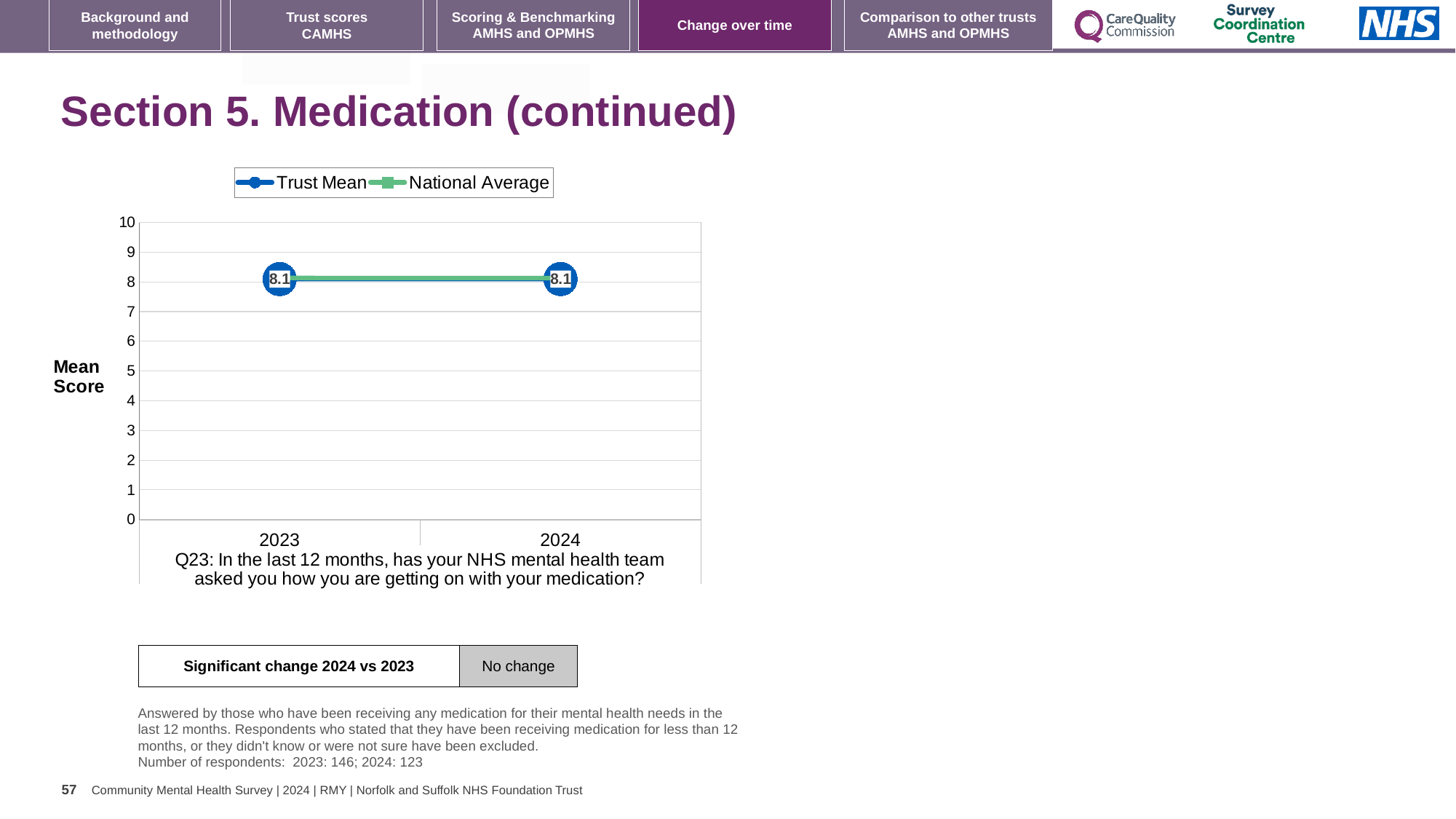
Is the Trust Mean value for 2023 greater or less than 9? less Which series is shown in green in the legend? National Average What is the Trust Mean value for 2024? 8.1 What is the difference between the Trust Mean in 2024 and in 2023? 0.0 What is the label on the y axis of the chart? Mean Score Does the Trust Mean rise, fall or stay the same from 2023 to 2024? stays the same How many years are plotted on the x axis? 2 What is the Trust Mean value for 2023? 8.1 Is the National Average value for 2024 greater or less than 5? greater What kind of chart is shown on the slide? line chart How many series does the legend list? 2